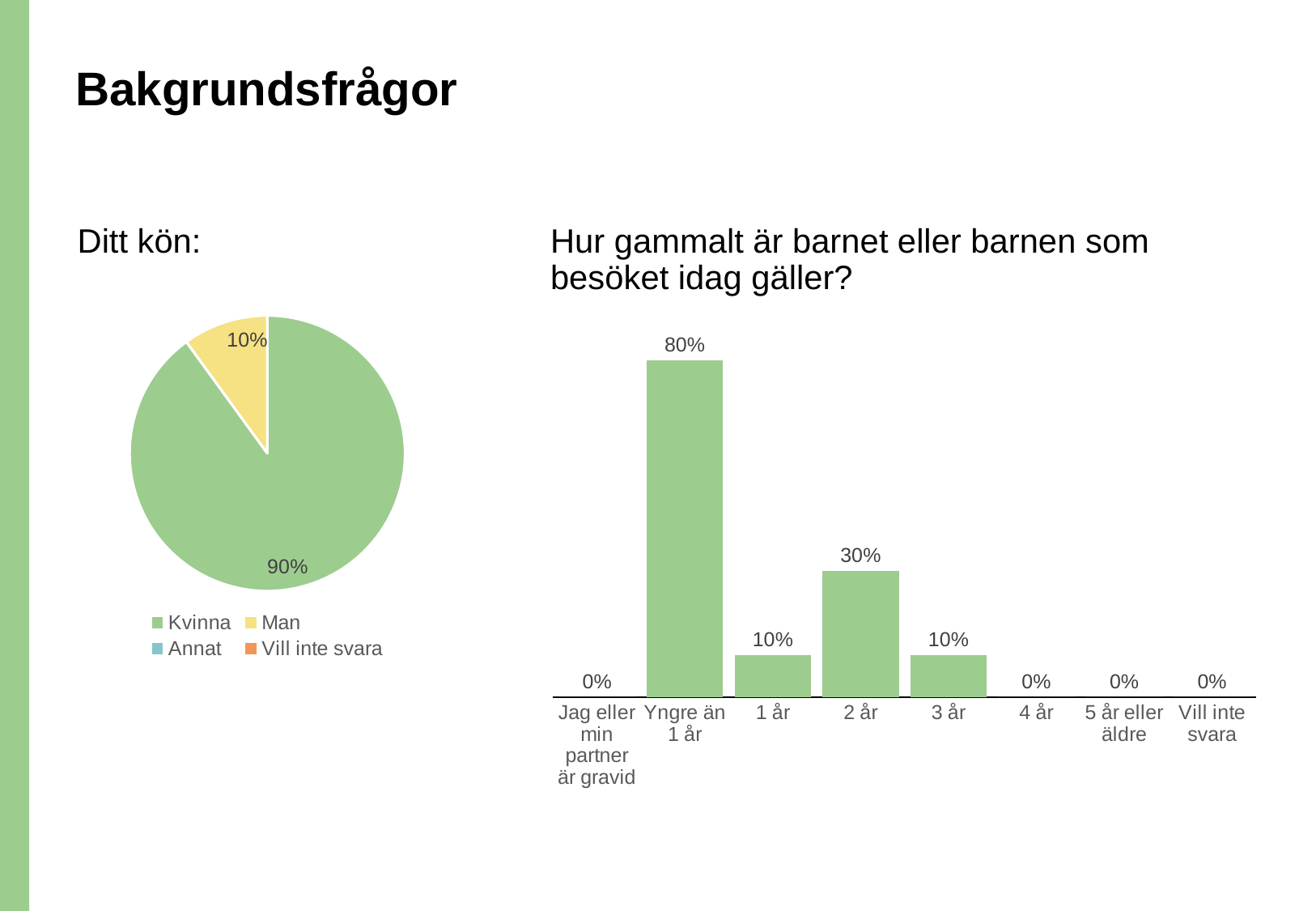
How many categories are shown on the x axis of the 'Hur gammalt är barnet eller barnen som besöket idag gäller?' chart? 8 In the 'Hur gammalt är barnet eller barnen som besöket idag gäller?' chart, what is the value for 'Yngre än 1 år'? 80% In the 'Hur gammalt är barnet eller barnen som besöket idag gäller?' chart, what is the difference between the values for 'Yngre än 1 år' and '2 år'? 50% What kind of chart is the 'Ditt kön:' chart? pie chart In the 'Hur gammalt är barnet eller barnen som besöket idag gäller?' chart, what is the value for '3 år'? 10% In the 'Hur gammalt är barnet eller barnen som besöket idag gäller?' chart, which category has the highest value? Yngre än 1 år In the 'Hur gammalt är barnet eller barnen som besöket idag gäller?' chart, what is the value for '2 år'? 30% In the 'Ditt kön:' pie chart, how many entries does the legend list? 4 What kind of chart is the 'Hur gammalt är barnet eller barnen som besöket idag gäller?' chart? bar chart In the 'Hur gammalt är barnet eller barnen som besöket idag gäller?' chart, which is larger, the value for '2 år' or the value for '1 år'? 2 år In the 'Ditt kön:' pie chart, what share is labelled for Kvinna? 90% In the 'Ditt kön:' pie chart, what share is labelled for Man? 10%